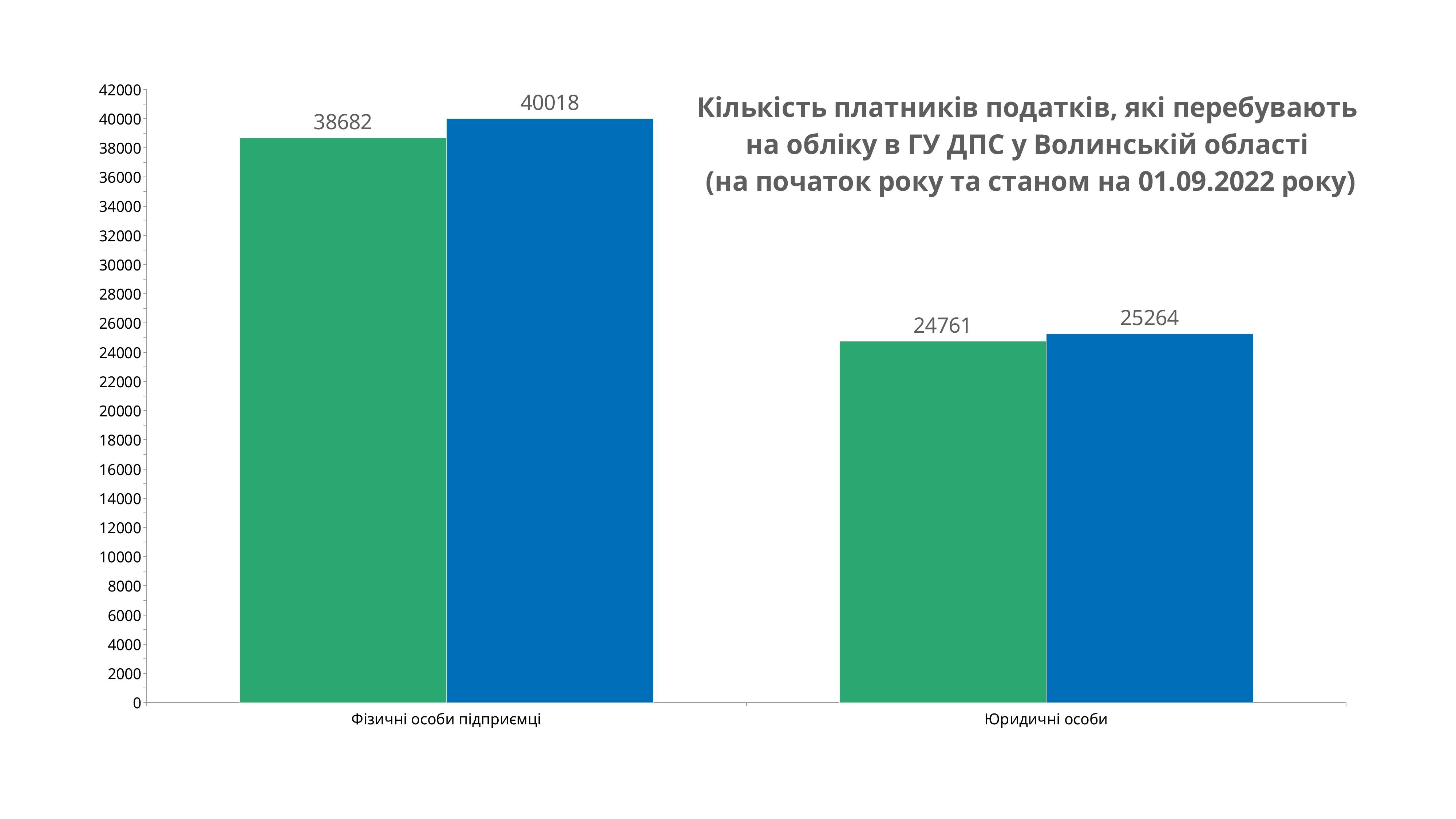
What is the value of the green bar for Юридичні особи? 24761 What is the value of the blue bar for Фізичні особи підприємці? 40018 What is the value of the green bar for Фізичні особи підприємці? 38682 What is the difference between the blue and green bars for Фізичні особи підприємці? 1336 What is the maximum value shown on the vertical axis? 42000 How many categories are shown on the x axis? 2 Which bar has the highest value on the chart? The blue bar for Фізичні особи підприємці (40018) What is the value of the blue bar for Юридичні особи? 25264 What type of chart is shown on the slide? Bar chart Which is larger: the green bar for Фізичні особи підприємці or the blue bar for Юридичні особи? The green bar for Фізичні особи підприємці Which bar has the lowest value on the chart? The green bar for Юридичні особи (24761) What is the difference between the blue and green bars for Юридичні особи? 503